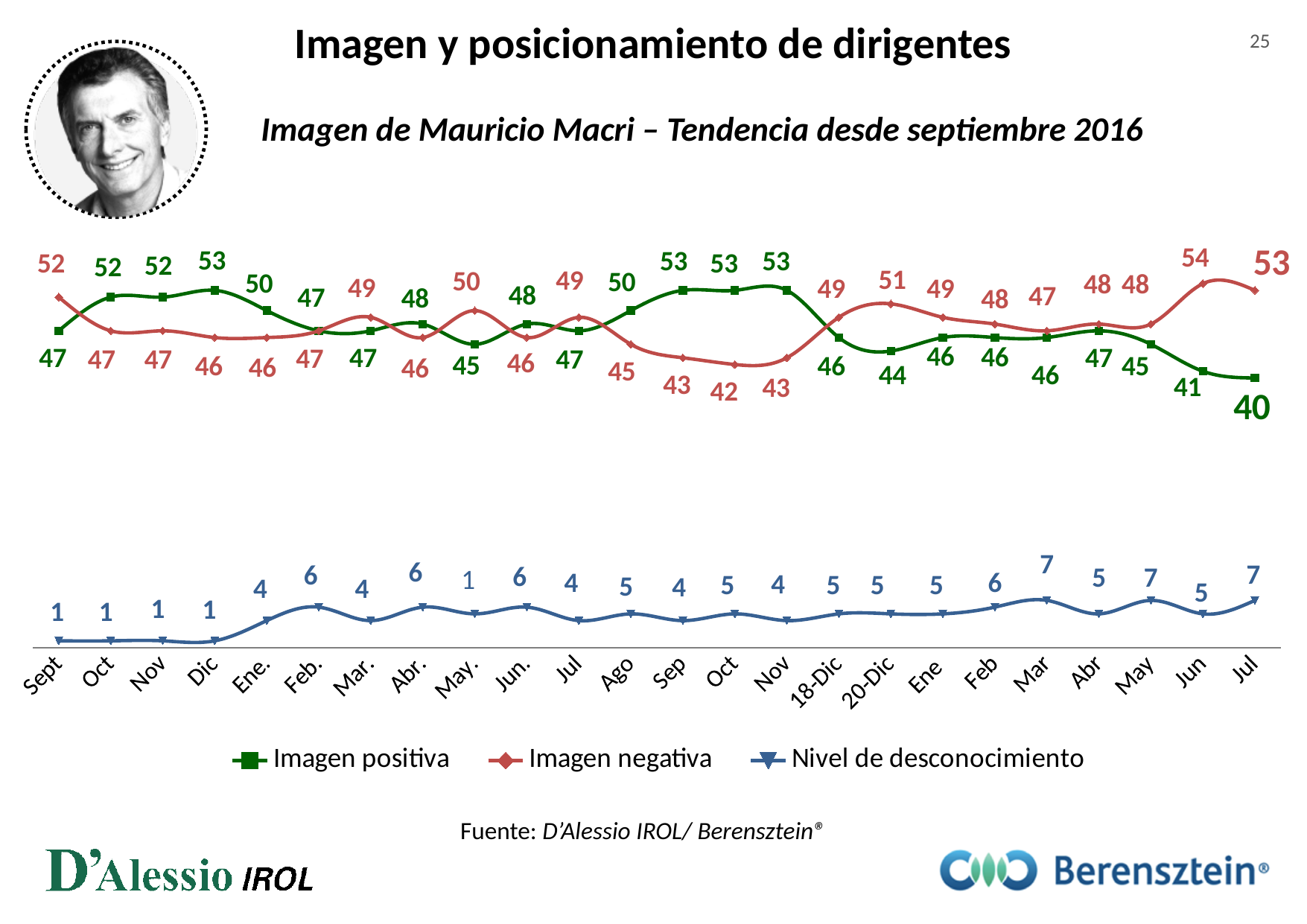
Does Imagen positiva rise or fall from the second Nov to the final Jul? fall What is the value of Imagen positiva at the last point, Jul? 40 At the last point, Jul, what is the difference between Imagen negativa and Imagen positiva? 13 At which point does Imagen negativa reach its lowest value? Oct At the first point, Sept, which is larger: Imagen positiva or Imagen negativa? Imagen negativa At which point does Imagen positiva reach its lowest value? Jul How many data points are plotted along the x axis for each series? 24 How many series does the legend list? 3 What is the value of Imagen negativa at 20-Dic? 51 What is the value of Nivel de desconocimiento at 18-Dic? 5 What kind of chart is shown on the slide? line chart At which point does Imagen negativa reach its highest value? Jun